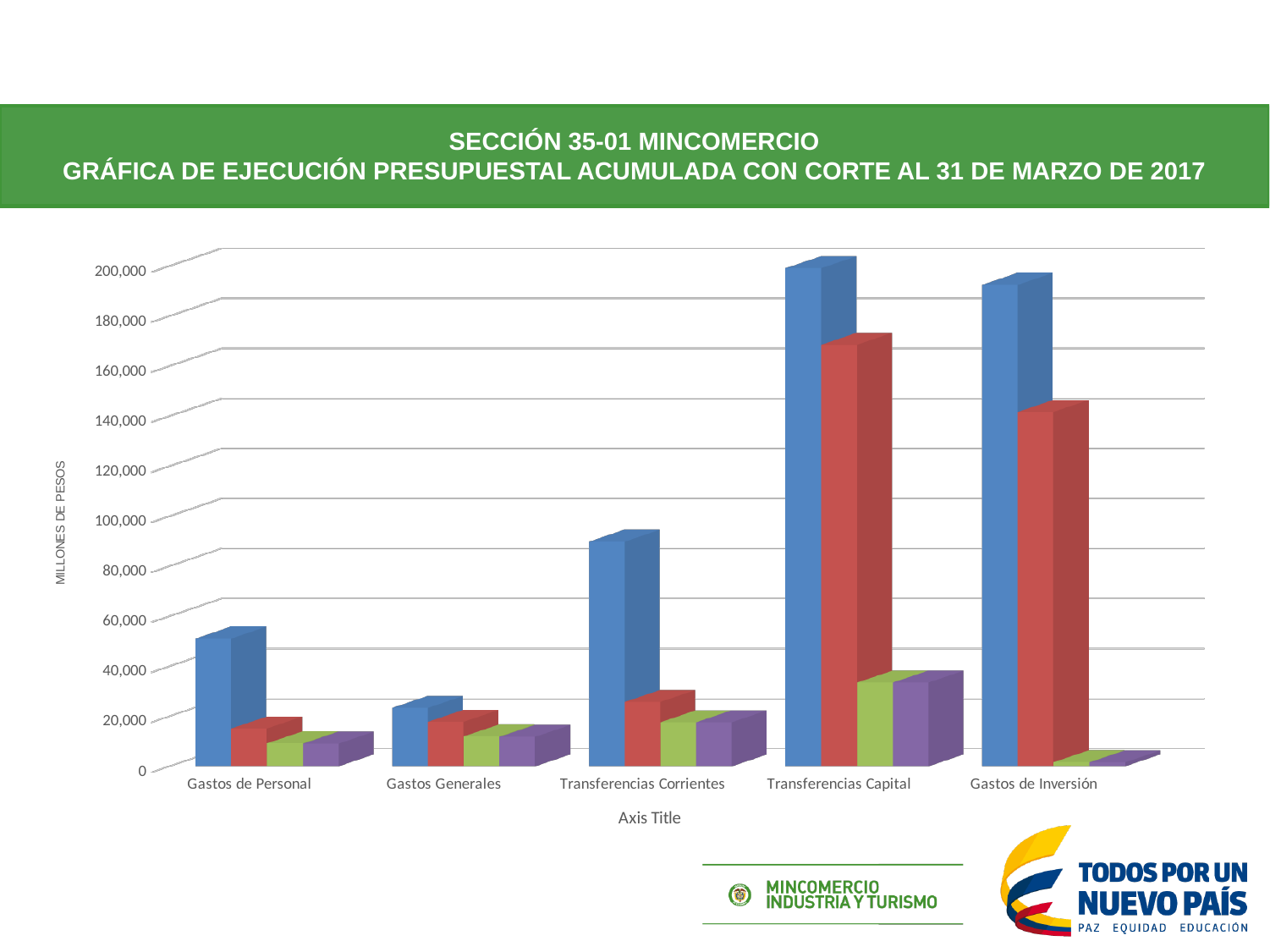
Which is larger, the blue bar for Gastos de Personal or the blue bar for Gastos Generales? Gastos de Personal What kind of chart is shown on the slide? Bar chart Is the value of the red bar for Gastos de Inversión greater or less than 120,000? greater Is the value of the blue bar for Transferencias Capital greater or less than 180,000? greater Is the value of the blue bar for Gastos Generales greater or less than 40,000? less Which category has the highest red bar? Transferencias Capital What is the title of the vertical axis of the chart? MILLONES DE PESOS What text appears as the horizontal axis title of the chart? Axis Title How many categories are shown on the x axis of the chart? 5 How many bars are plotted for each category in the chart? 4 Which category has the lowest blue bar? Gastos Generales